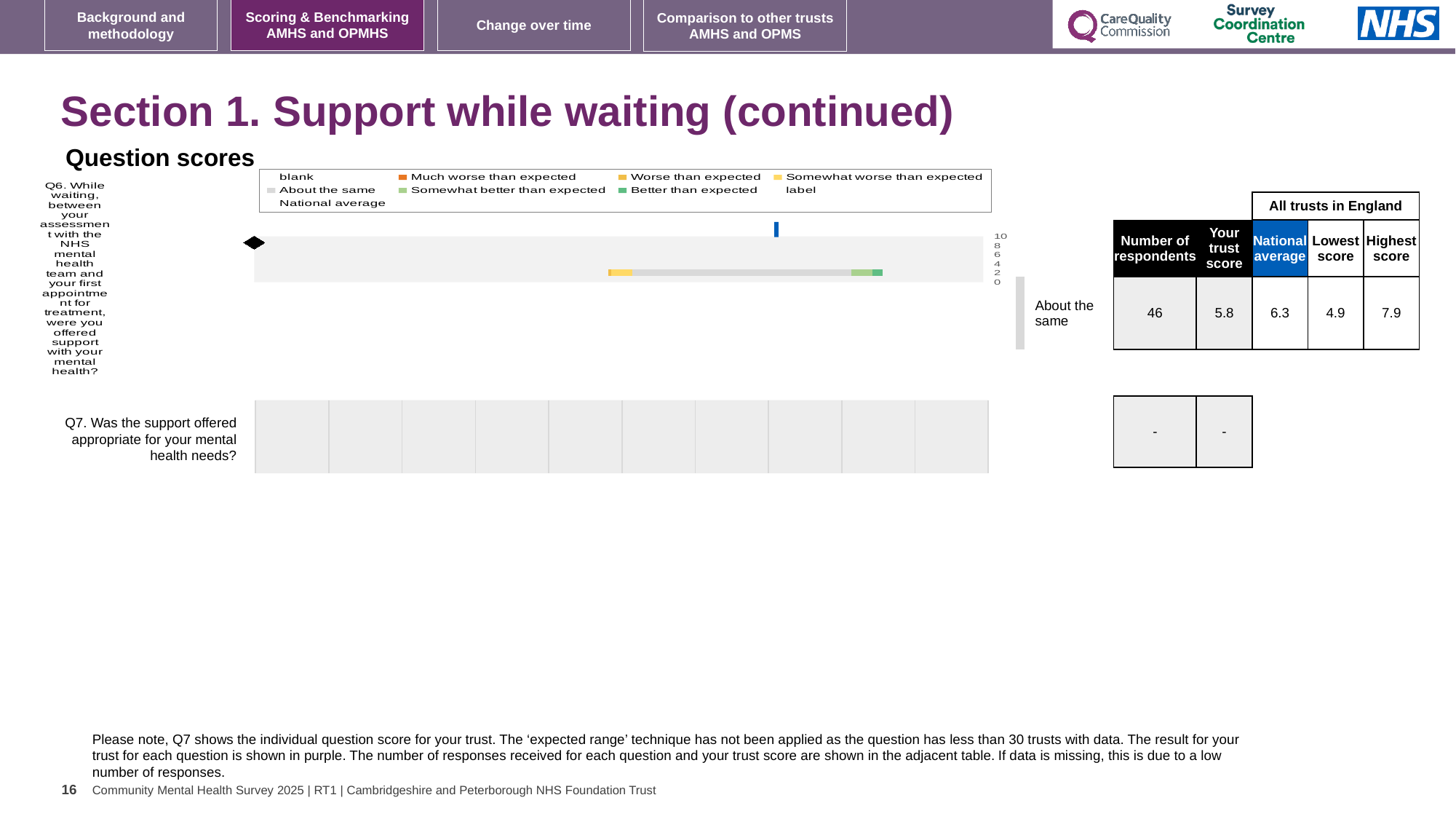
In the question scores chart, what is the trust score shown for Q6? 5.8 For Q6, is the trust score larger or smaller than the national average? smaller What is the difference between the highest score and the lowest score for Q6? 3.0 In the question scores chart, what is the lowest score among all trusts in England for Q6? 4.9 What is the difference between the national average and the trust score for Q6? 0.5 What colour is the legend entry for 'Better than expected' in the question scores chart? green How many respondents are shown for Q6 in the question scores chart? 46 What kind of chart is used to show the question scores on this slide? bar chart In the question scores chart, what is the highest score among all trusts in England for Q6? 7.9 Which expected-range category is the trust's result for Q6 labelled as in the question scores chart? About the same In the question scores chart, what is the national average shown for Q6? 6.3